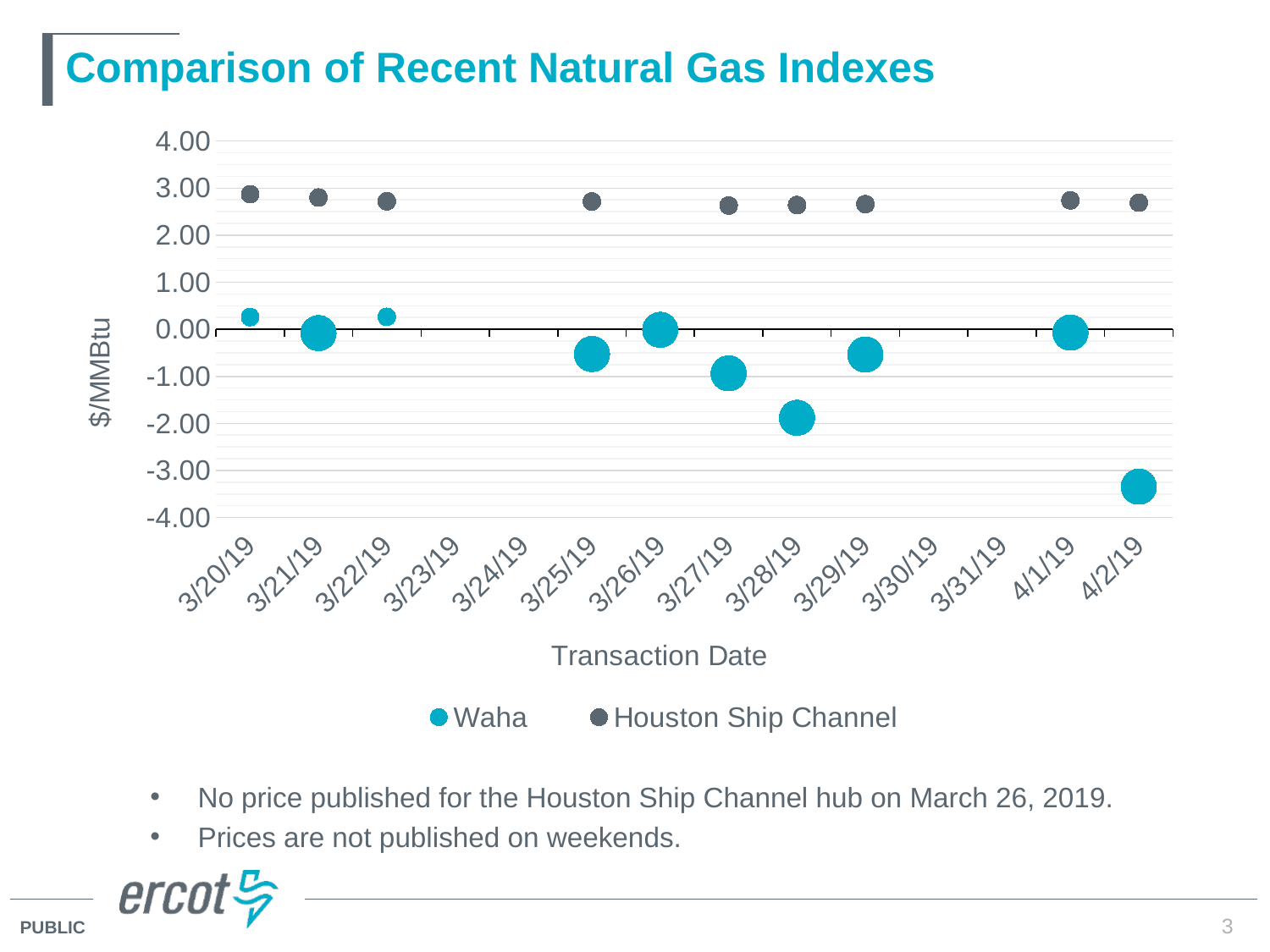
Do the Waha values generally rise or fall from 3/20/19 to 4/2/19? fall On 3/27/19, which series has the larger value, Waha or Houston Ship Channel? Houston Ship Channel How many transaction dates are labelled on the x axis? 14 How many Waha data points are plotted? 10 How many series does the legend list? 2 Is the Waha value on 4/2/19 greater or less than -3.00? less On which transaction date is the Waha value lowest? 4/2/19 What are the two series named in the legend? Waha and Houston Ship Channel Is the Houston Ship Channel value on 3/20/19 greater or less than 2.00? greater Is the Waha value on 3/20/19 greater or less than 0.00? greater What kind of chart is shown on the slide? Bubble chart